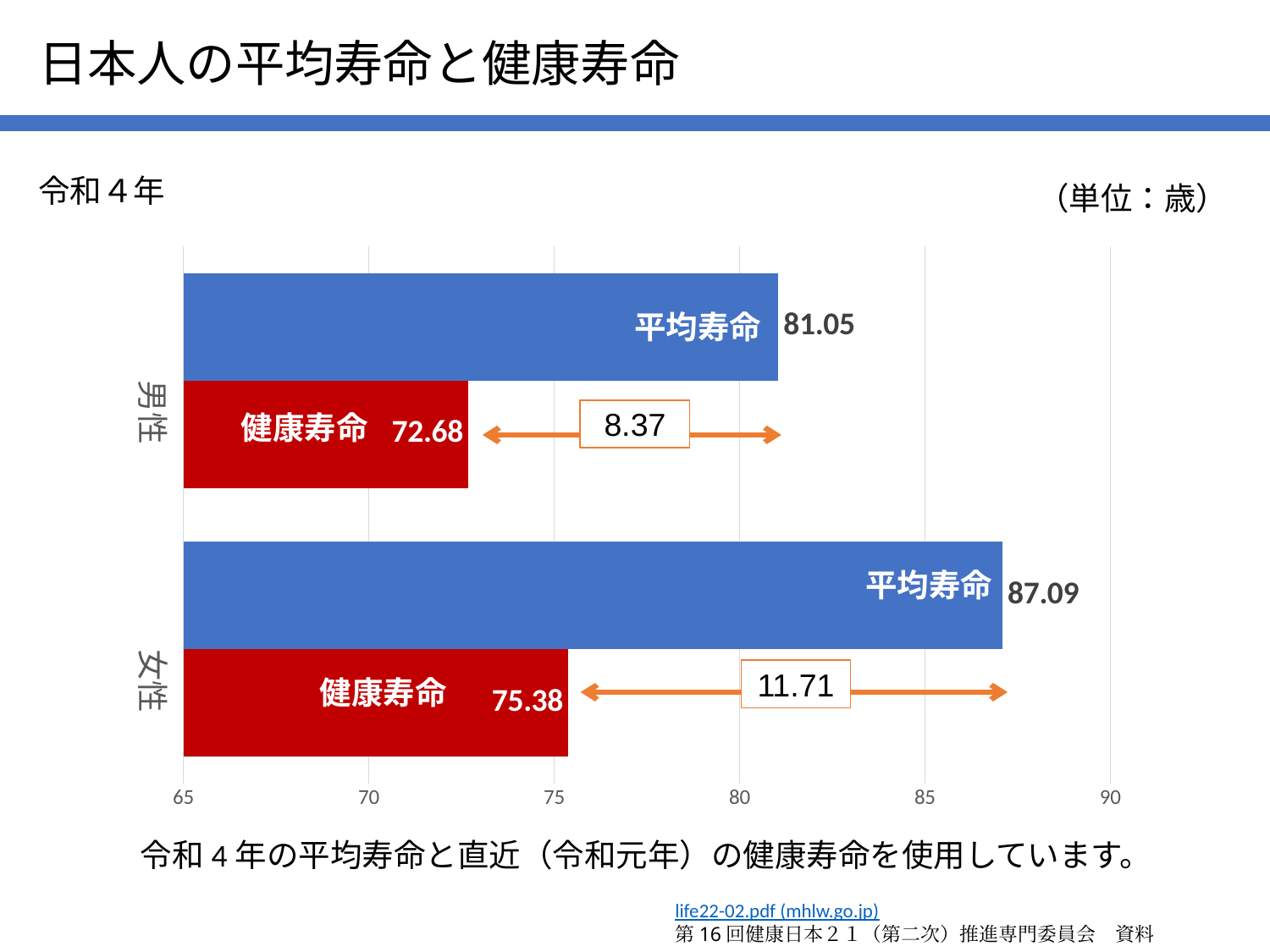
What is the 健康寿命 value for 男性? 72.68 Which is larger, the 健康寿命 for 男性 or the 健康寿命 for 女性? 女性 Is the 平均寿命 value for 男性 greater or less than 80? greater What is the difference between 平均寿命 and 健康寿命 for 女性? 11.71 What is the difference between 平均寿命 and 健康寿命 for 男性? 8.37 What is the 健康寿命 value for 女性? 75.38 Which bar has the highest value on the chart? 女性 平均寿命 What is the 平均寿命 value for 男性? 81.05 What is the 平均寿命 value for 女性? 87.09 What unit is shown for the values on the chart? 歳 Which bar has the lowest value on the chart? 男性 健康寿命 What kind of chart is shown on the slide? bar chart